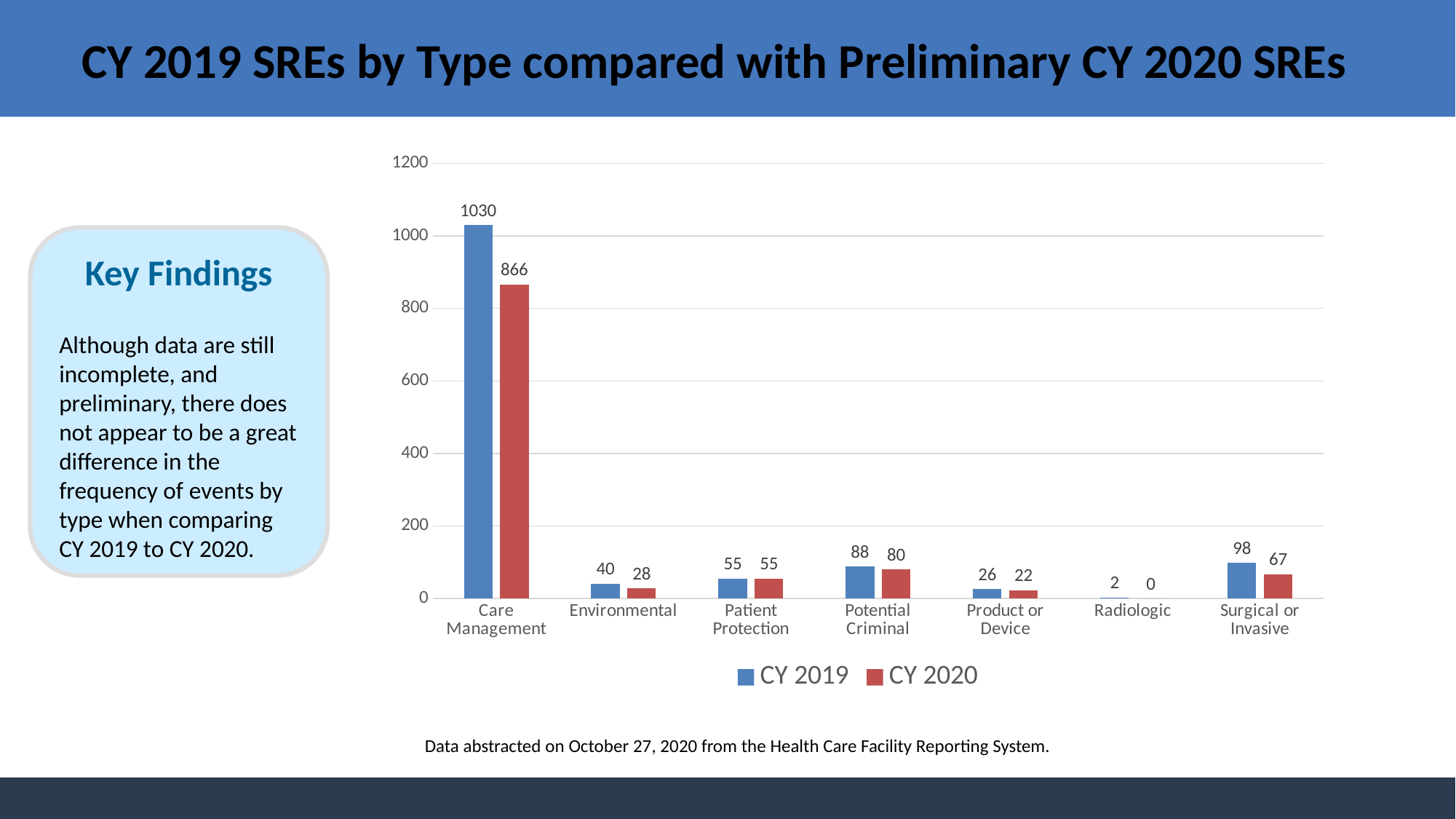
What is the CY 2019 value for Care Management? 1030 What is the difference between the CY 2019 and CY 2020 values for Surgical or Invasive? 31 Which category has the lowest CY 2019 value? Radiologic Which is larger for Potential Criminal, the CY 2019 value or the CY 2020 value? CY 2019 How many series does the legend list? 2 Is the CY 2020 value for Care Management greater or less than 800? greater What is the difference between the CY 2019 and CY 2020 values for Care Management? 164 What kind of chart is shown on the slide? Bar chart How many categories are shown on the x axis? 7 Which category has the highest CY 2020 value? Care Management What is the CY 2020 value for Radiologic? 0 What is the CY 2020 value for Surgical or Invasive? 67